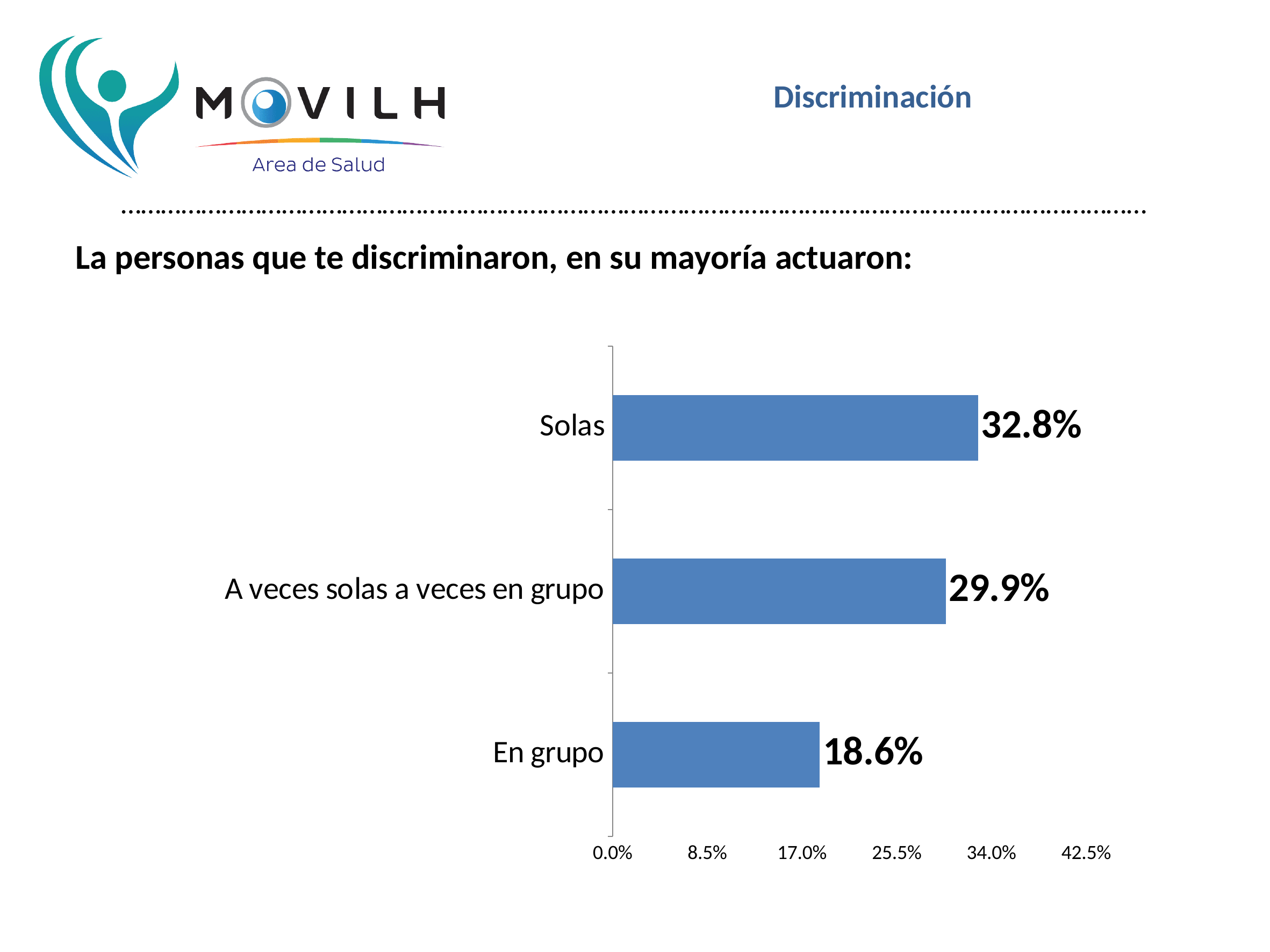
Which category has the lowest value? En grupo What is the title of the chart on the slide? La personas que te discriminaron, en su mayoría actuaron: What is the value for "Solas"? 32.8% What is the difference between the values for "Solas" and "En grupo"? 14.2% What is the difference between the values for "Solas" and "A veces solas a veces en grupo"? 2.9% What is the value for "En grupo"? 18.6% How many categories are shown in the chart? 3 What is the value for "A veces solas a veces en grupo"? 29.9% Which is larger, the value for "A veces solas a veces en grupo" or the value for "En grupo"? A veces solas a veces en grupo Which category has the highest value? Solas Is the value for "En grupo" greater or less than 25.5%? less What kind of chart is shown on the slide? Bar chart